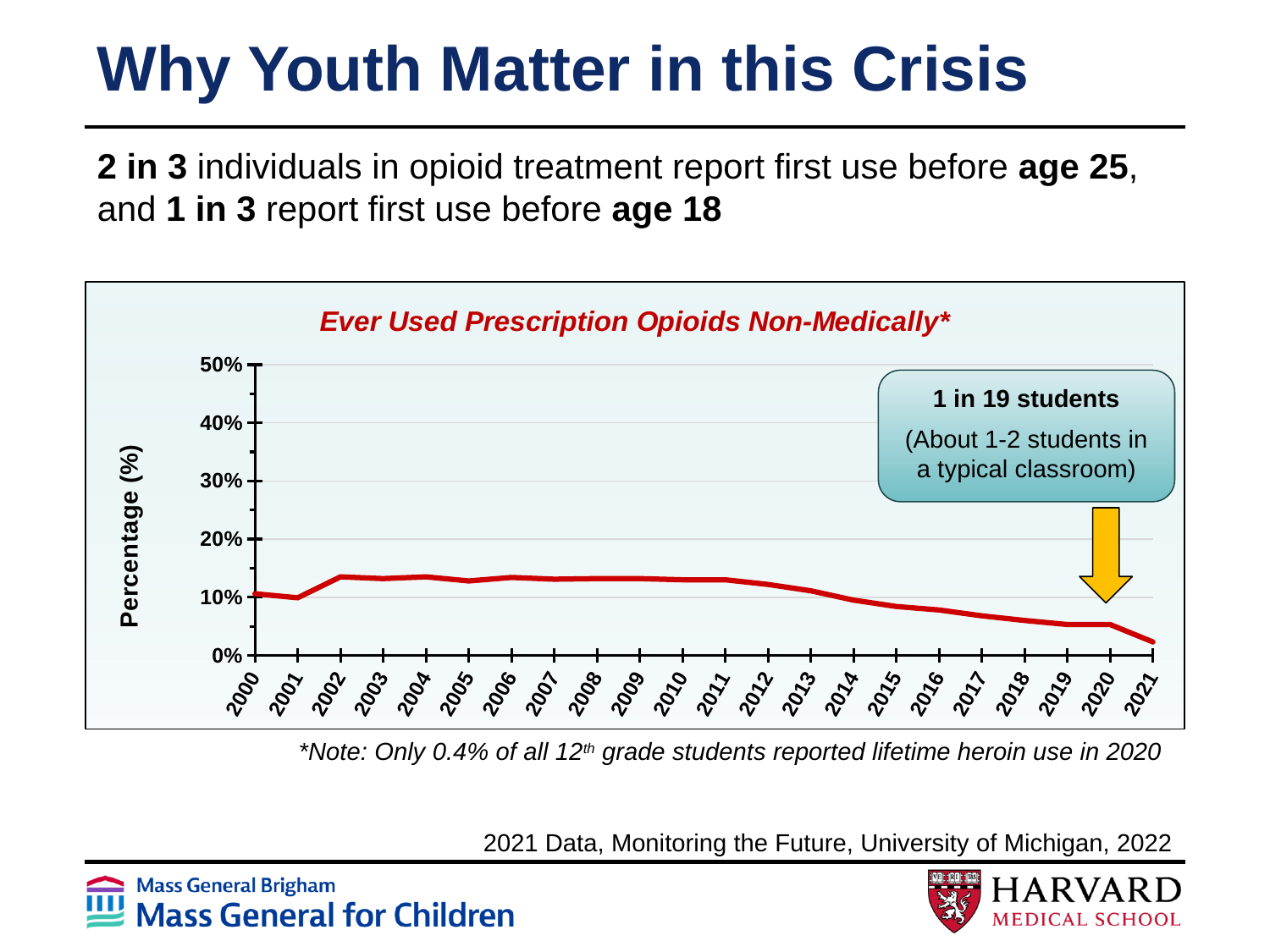
Is the value for 2008 greater or less than 10%? greater What is the label on the y axis of the chart? Percentage (%) What is the title of the chart? Ever Used Prescription Opioids Non-Medically* Is the value for 2020 greater or less than 10%? less Which year has the larger value, 2002 or 2021? 2002 Is the value for 2002 greater or less than 10%? greater Which year has the lowest value on the chart? 2021 Does the line generally rise or fall from 2011 to 2021? fall How many years are shown along the x axis of the chart? 22 What kind of chart is shown on the slide? line chart